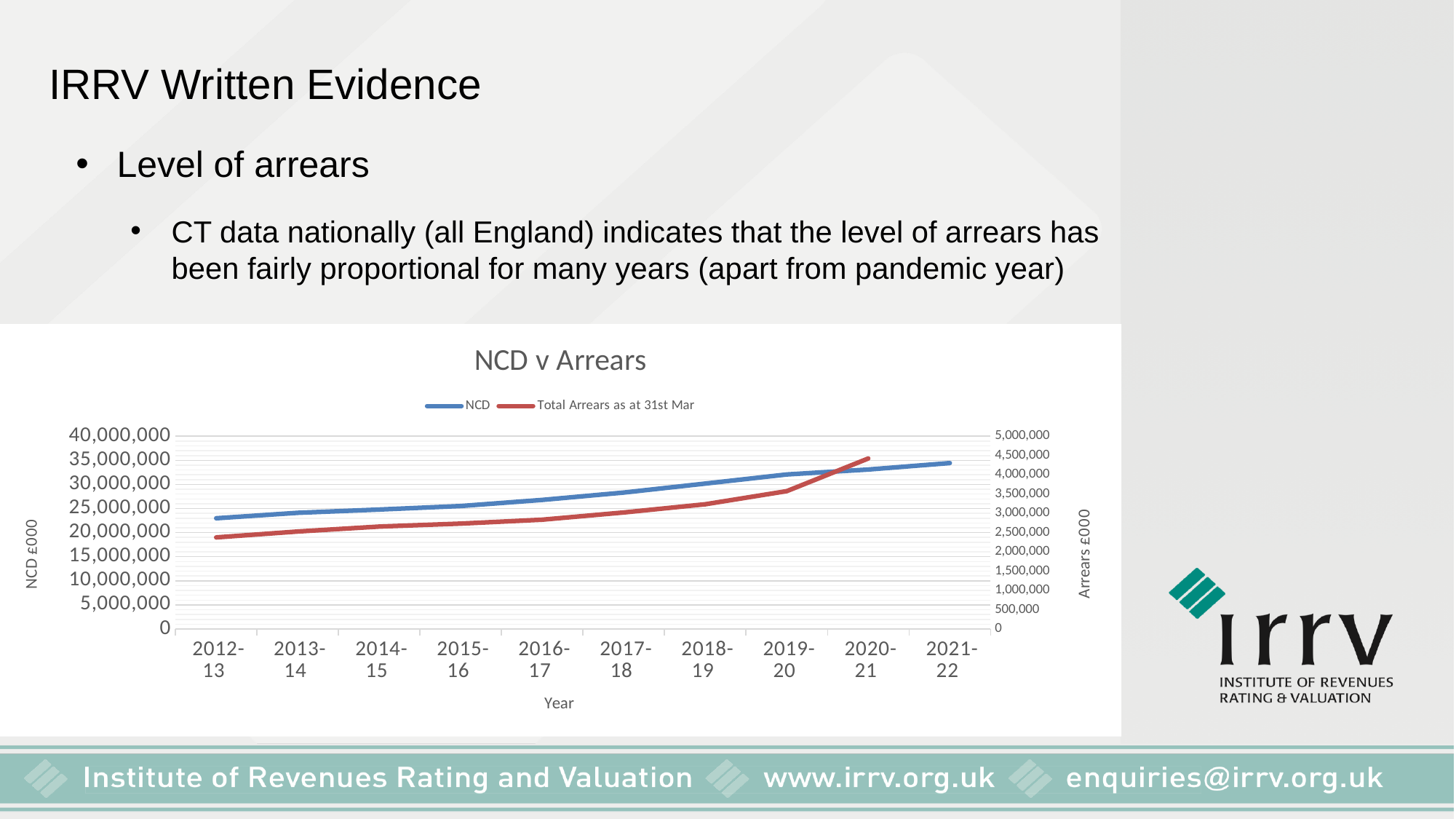
Does the Total Arrears as at 31st Mar line rise or fall from 2012-13 to 2020-21? Rise How many years are shown along the x axis of the chart? 10 Is the Total Arrears as at 31st Mar value for 2020-21 greater or less than 4,000,000 on the right axis? greater What is the label of the left vertical axis? NCD £000 How many series does the chart legend list? 2 Is the Total Arrears as at 31st Mar value for 2012-13 greater or less than 2,000,000 on the right axis? greater Which year has the highest NCD value? 2021-22 Does the NCD line rise or fall from 2012-13 to 2021-22? Rise Is the NCD value for 2012-13 greater or less than 20,000,000 on the left axis? greater What is the title of the chart? NCD v Arrears What type of chart is shown on the slide? Line chart